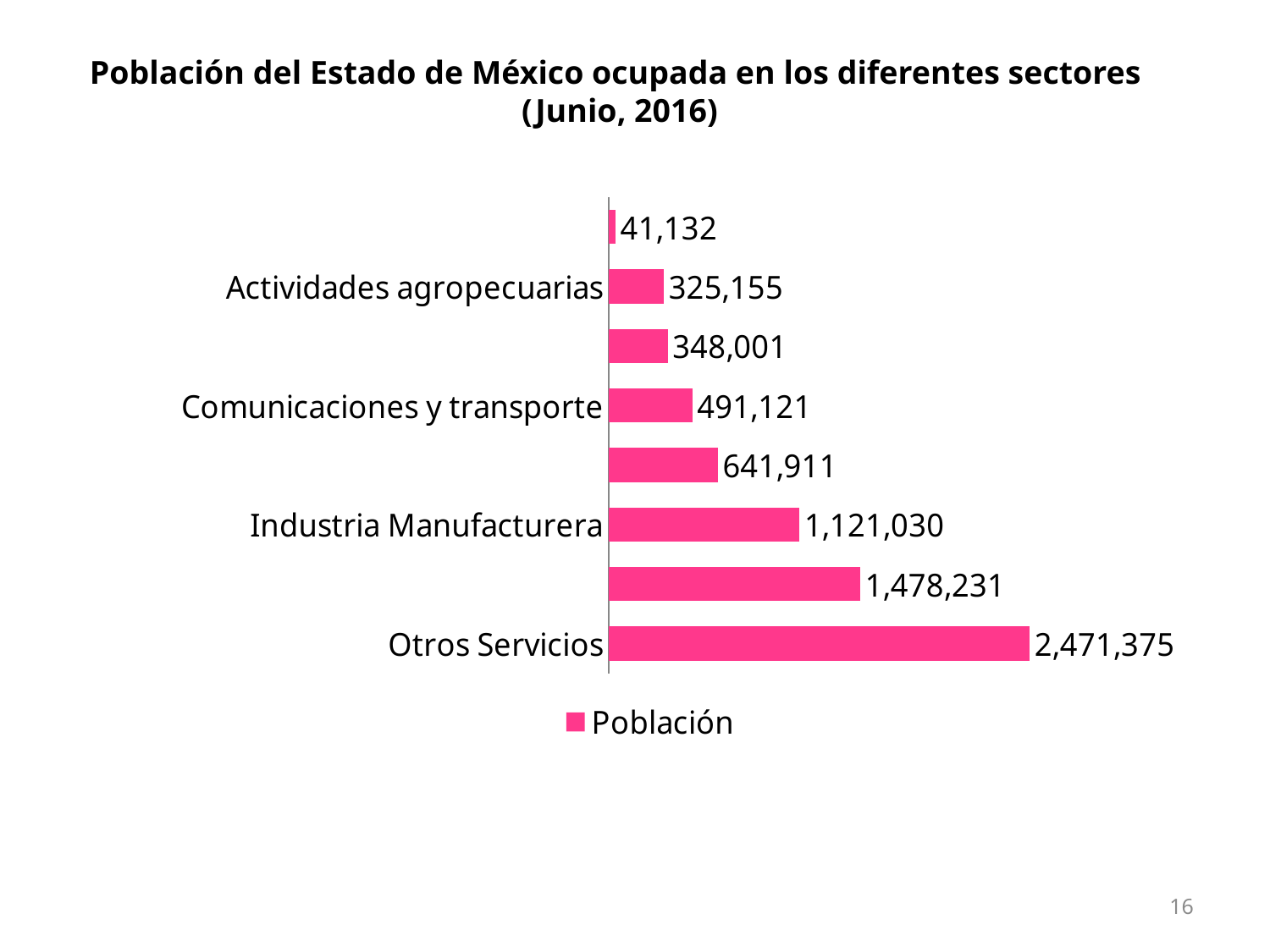
What is the value for Comunicaciones y transporte? 491,121 Which category has the highest value? Otros Servicios Which is larger, Industria Manufacturera or Comunicaciones y transporte? Industria Manufacturera How many series does the legend list? 1 What is the value for Industria Manufacturera? 1,121,030 What kind of chart is shown? Bar chart What is the value for Otros Servicios? 2,471,375 What is the name of the series shown in the legend? Población What is the difference between Otros Servicios and Industria Manufacturera? 1,350,345 What is the difference between Comunicaciones y transporte and Actividades agropecuarias? 165,966 What is the value for Actividades agropecuarias? 325,155 How many bars are plotted in the chart? 8